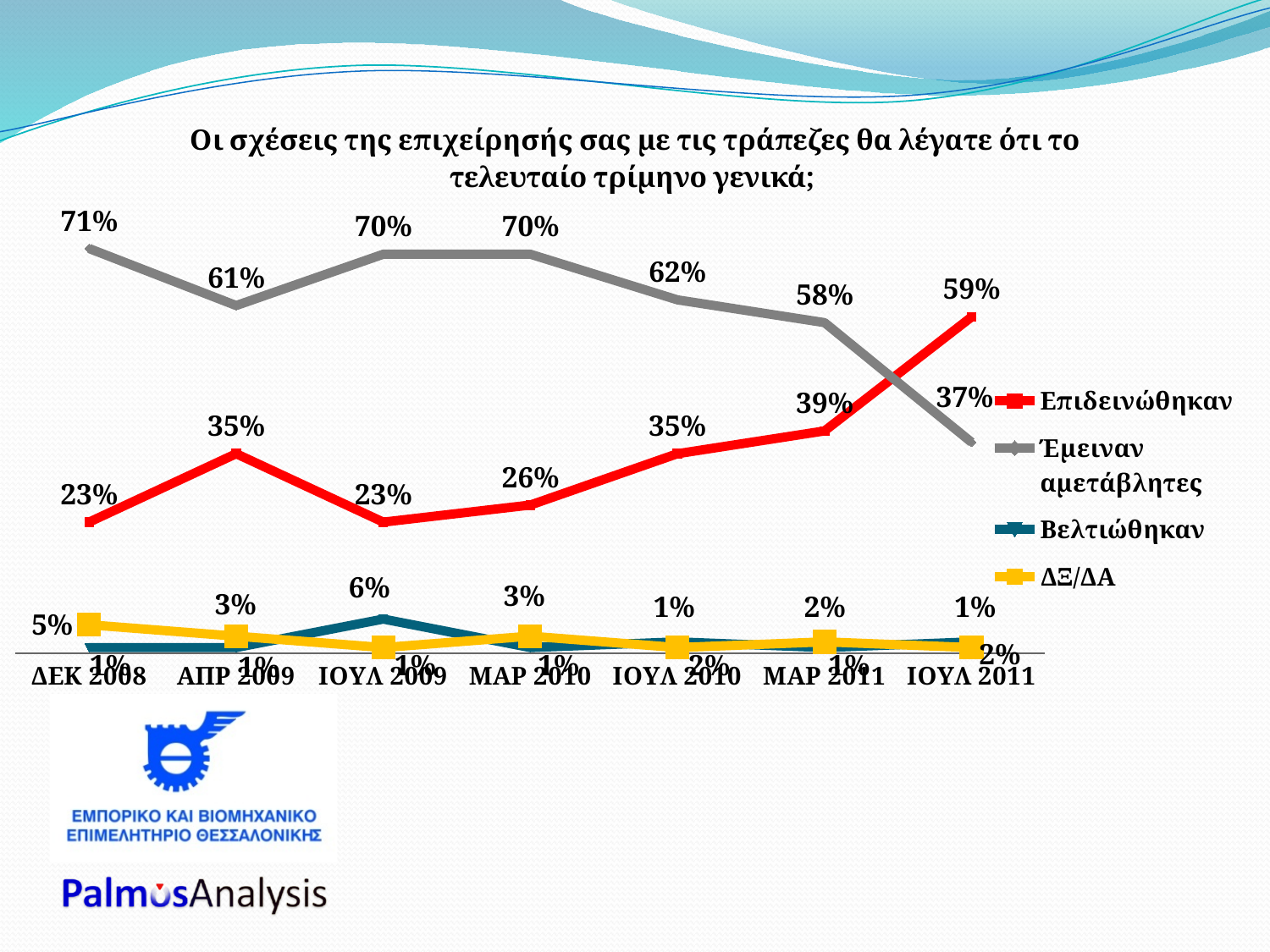
At which time point is Έμειναν αμετάβλητες lowest? ΙΟΥΛ 2011 What kind of chart is shown on the slide? Line chart How many series does the legend list? 4 What is the value for Επιδεινώθηκαν at ΙΟΥΛ 2011? 59% Does the Επιδεινώθηκαν series rise or fall from ΜΑΡ 2010 to ΙΟΥΛ 2011? Rise At ΙΟΥΛ 2011, which is larger: Επιδεινώθηκαν or Έμειναν αμετάβλητες? Επιδεινώθηκαν What is the value for Επιδεινώθηκαν at ΑΠΡ 2009? 35% How many time points are shown on the x axis? 7 What is the value for Έμειναν αμετάβλητες at ΔΕΚ 2008? 71% What is the difference between Έμειναν αμετάβλητες and Επιδεινώθηκαν at ΔΕΚ 2008? 48% At which time point is Επιδεινώθηκαν highest? ΙΟΥΛ 2011 What is the value for Έμειναν αμετάβλητες at ΜΑΡ 2011? 58%